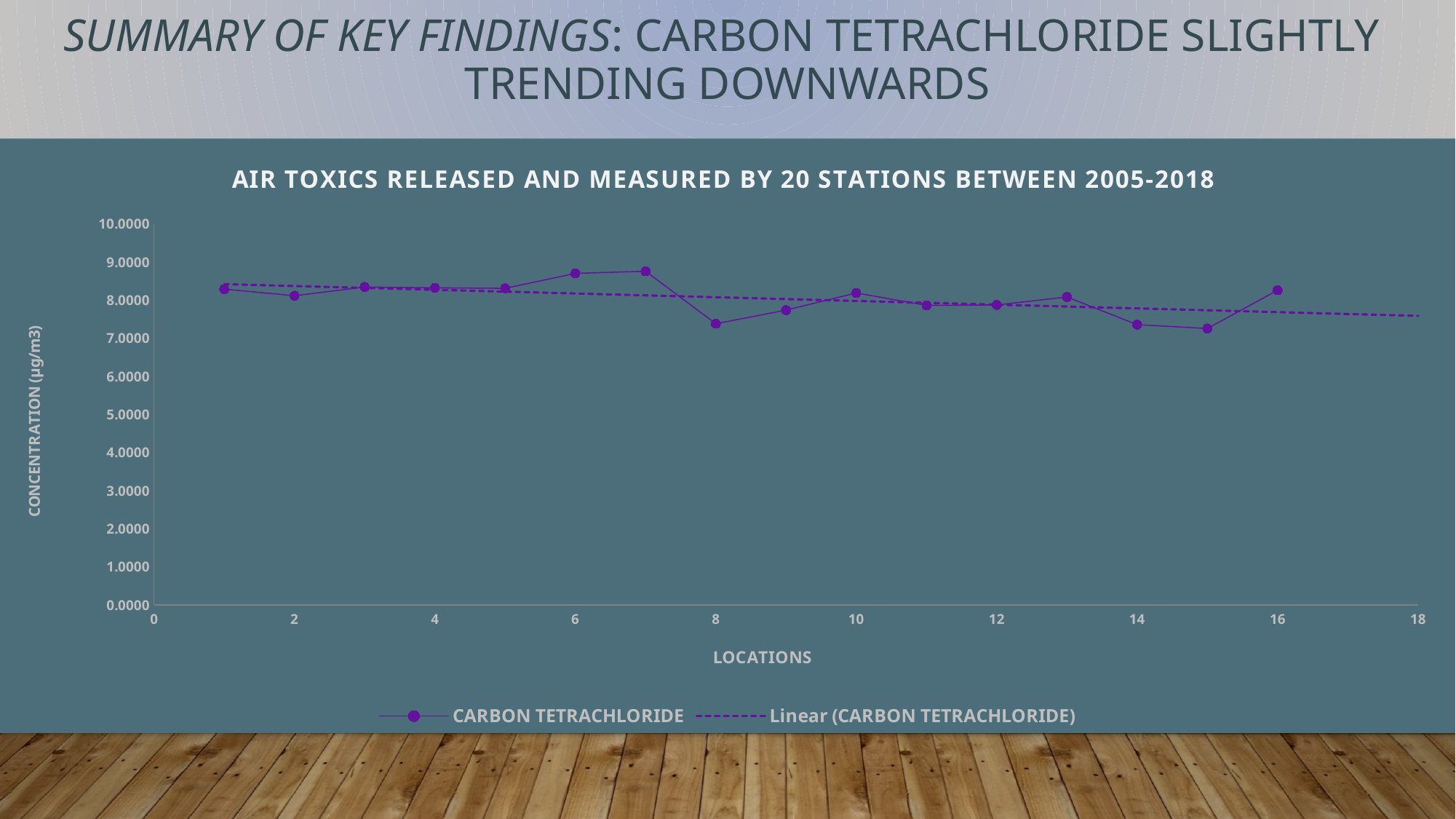
According to the linear trendline, do CARBON TETRACHLORIDE values rise or fall across the locations? Fall Which has the larger CARBON TETRACHLORIDE value, location 14 or location 16? Location 16 Is the CARBON TETRACHLORIDE value at location 8 greater or less than 8.0000? less Is the CARBON TETRACHLORIDE value at location 6 greater or less than 8.0000? greater How many entries does the legend list? 2 Is the CARBON TETRACHLORIDE value at location 15 greater or less than 8.0000? less What is the title of the chart? AIR TOXICS RELEASED AND MEASURED BY 20 STATIONS BETWEEN 2005-2018 How many data points are plotted for CARBON TETRACHLORIDE? 16 Which has the larger CARBON TETRACHLORIDE value, location 6 or location 8? Location 6 What kind of chart is shown on the slide? Line chart What is the label of the vertical axis? CONCENTRATION (µg/m3)